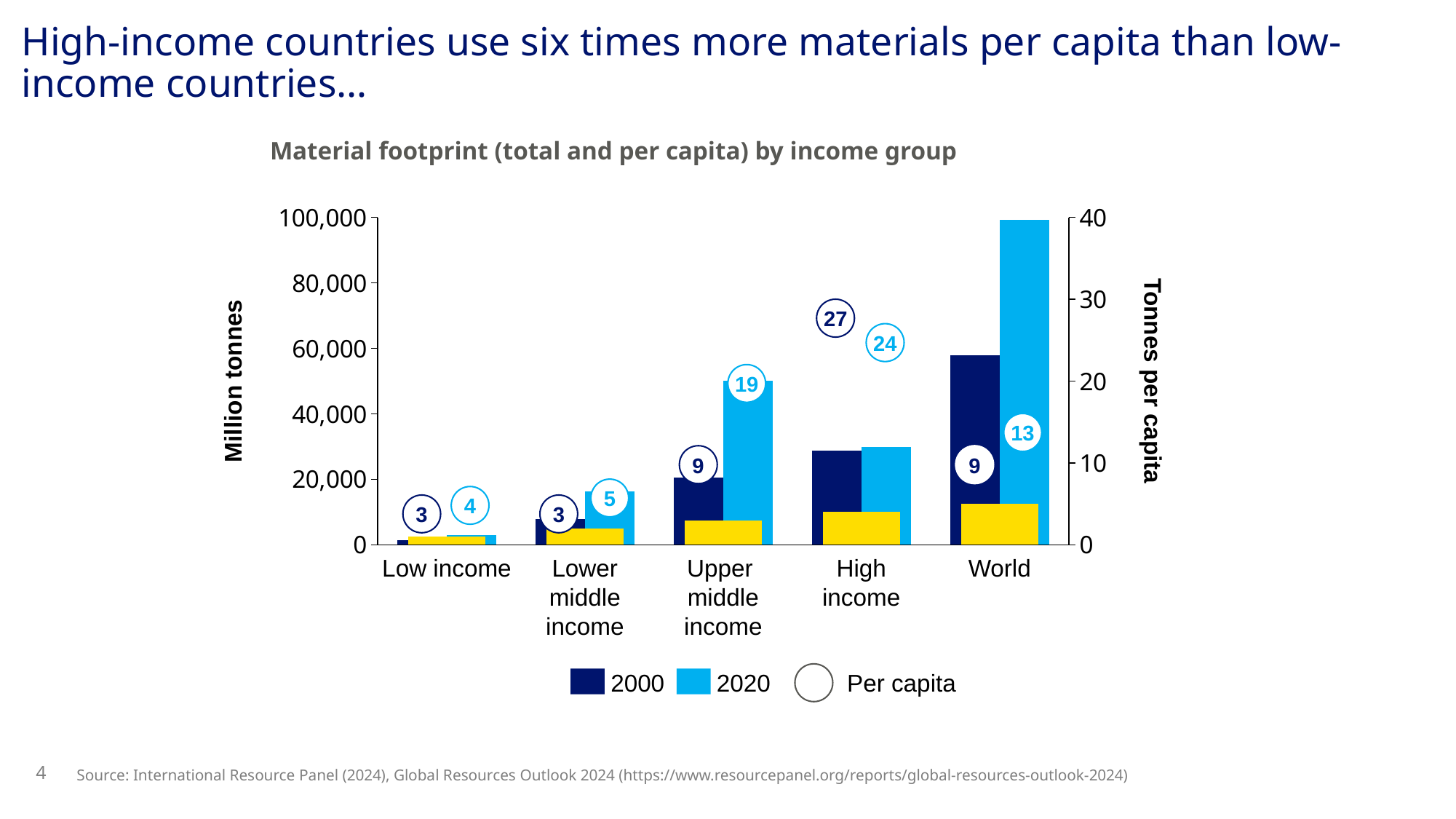
By how many tonnes per capita did the High income per capita value fall from 2000 to 2020? 3 What kind of chart is used to show the material footprint by income group? Bar chart How many entries does the legend list? 3 Is the 2020 total material footprint bar for World greater or less than 80,000 million tonnes? greater What is the per capita material footprint for High income in 2020, as shown in the circle label? 24 Which income group has the highest per capita value in 2000? High income Which has the larger per capita value in 2020: Upper middle income or World? Upper middle income What is the per capita value shown for World in 2020? 13 What is the per capita value shown for Upper middle income in 2000? 9 Is the 2000 total material footprint bar for Upper middle income greater or less than 40,000 million tonnes? less Which income group has the lowest 2020 total material footprint bar? Low income How many income group categories are shown on the x axis? 5